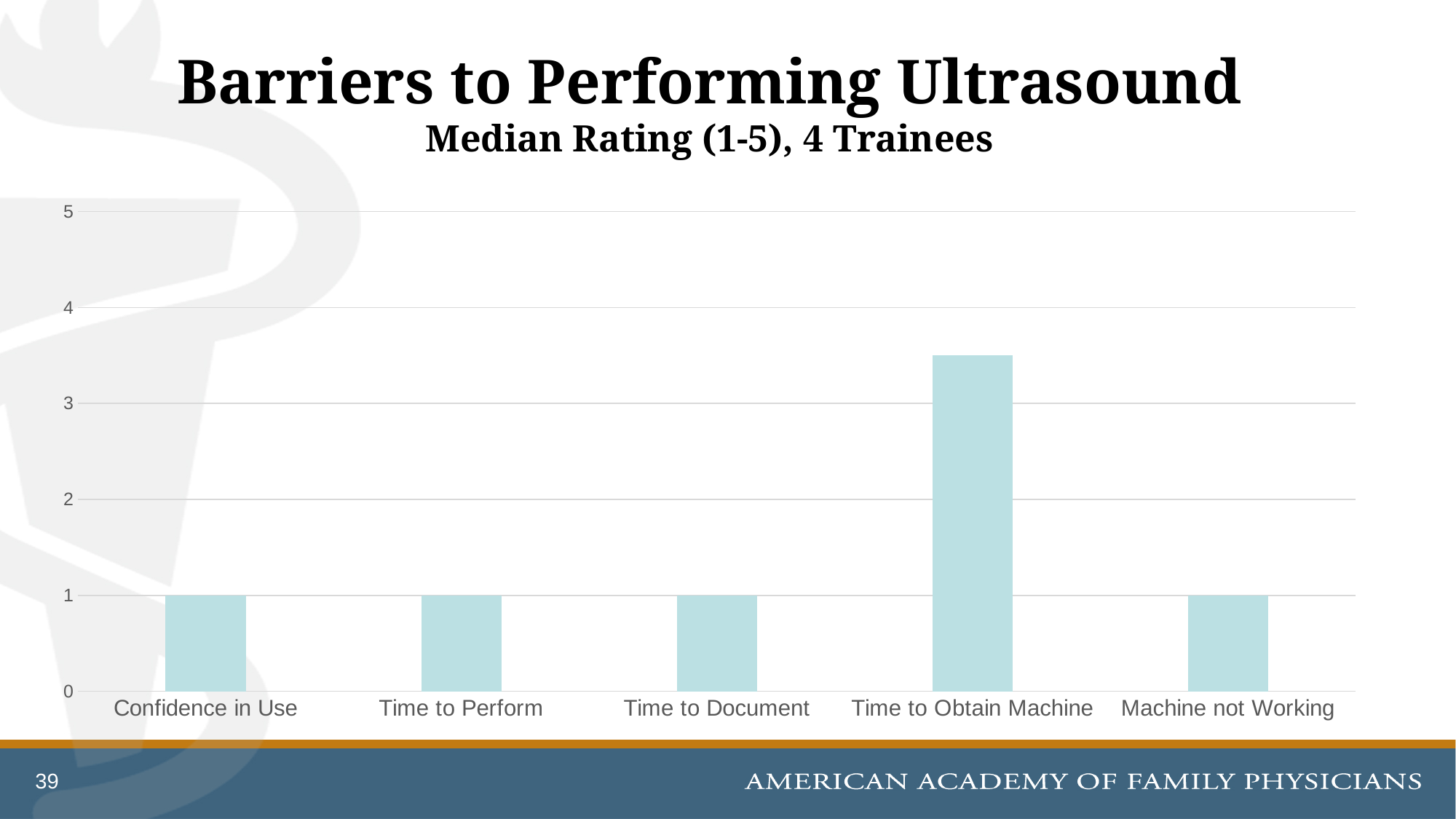
Which barrier has the highest median rating? Time to Obtain Machine What is the median rating for Machine not Working? 1 What is the title of the chart on the slide? Barriers to Performing Ultrasound Is the value for Time to Obtain Machine greater or less than 3? greater Which has a larger median rating, Time to Obtain Machine or Time to Document? Time to Obtain Machine What kind of chart is shown on the slide? bar chart What is the median rating for Confidence in Use? 1 Is the value for Time to Obtain Machine greater or less than 4? less What is the highest value shown on the y axis of the chart? 5 How many categories are shown on the x axis of the chart? 5 What is the median rating for Time to Perform? 1 What is the median rating for Time to Document? 1